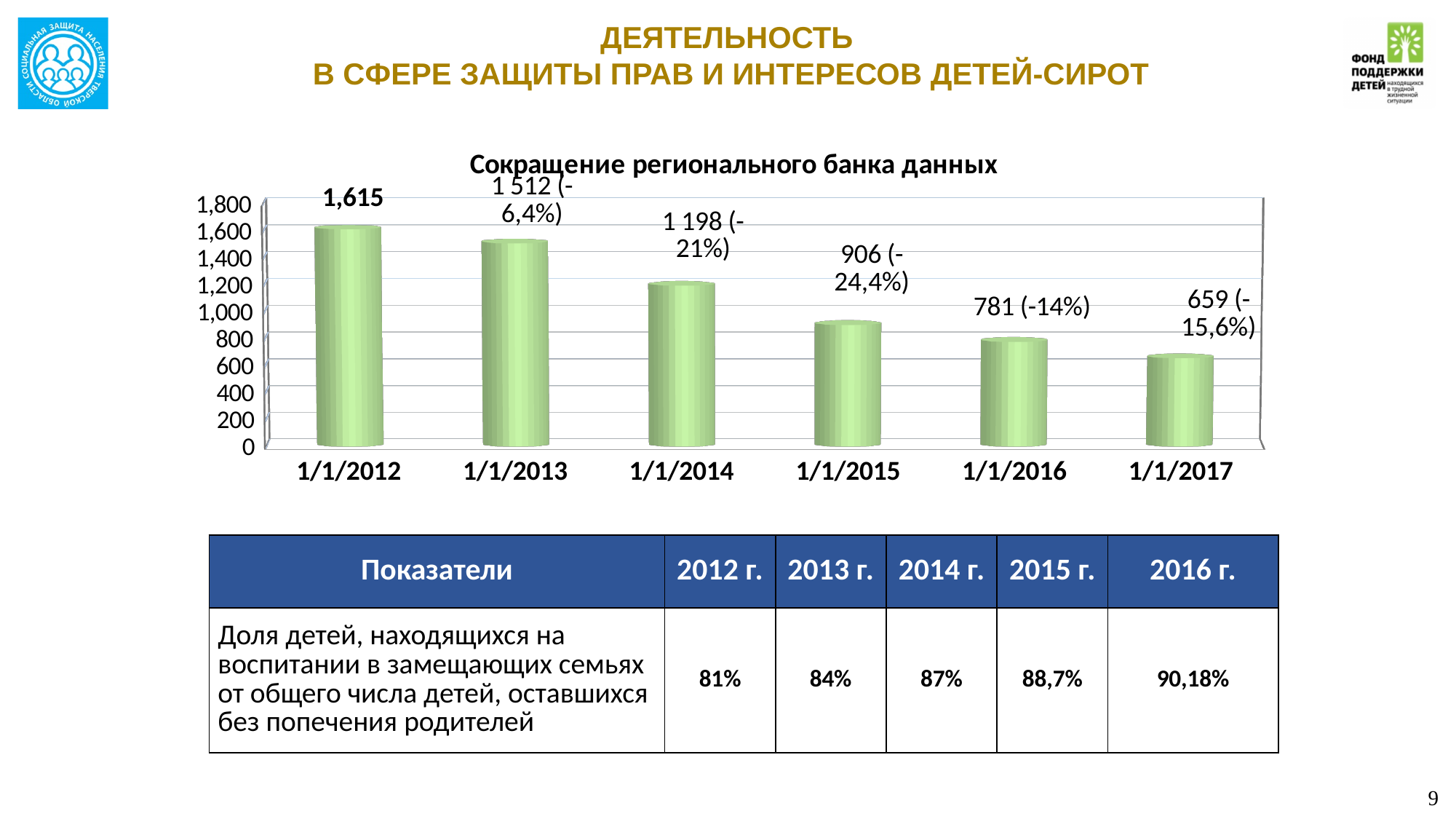
Which date has the highest value in the chart? 1/1/2012 What kind of chart is shown on the slide? bar chart What is the value for 1/1/2017 in the chart? 659 What is the value for 1/1/2015 in the chart? 906 Do the values rise or fall from 1/1/2012 to 1/1/2017? fall What is the value for 1/1/2012 in the chart 'Сокращение регионального банка данных'? 1,615 What is the difference between the values for 1/1/2012 and 1/1/2013? 103 Which is larger, the value for 1/1/2014 or the value for 1/1/2015? 1/1/2014 What is the difference between the values for 1/1/2016 and 1/1/2017? 122 Which date has the lowest value in the chart? 1/1/2017 What percentage change is shown next to the 1/1/2014 bar? -21% How many bars are shown in the chart? 6